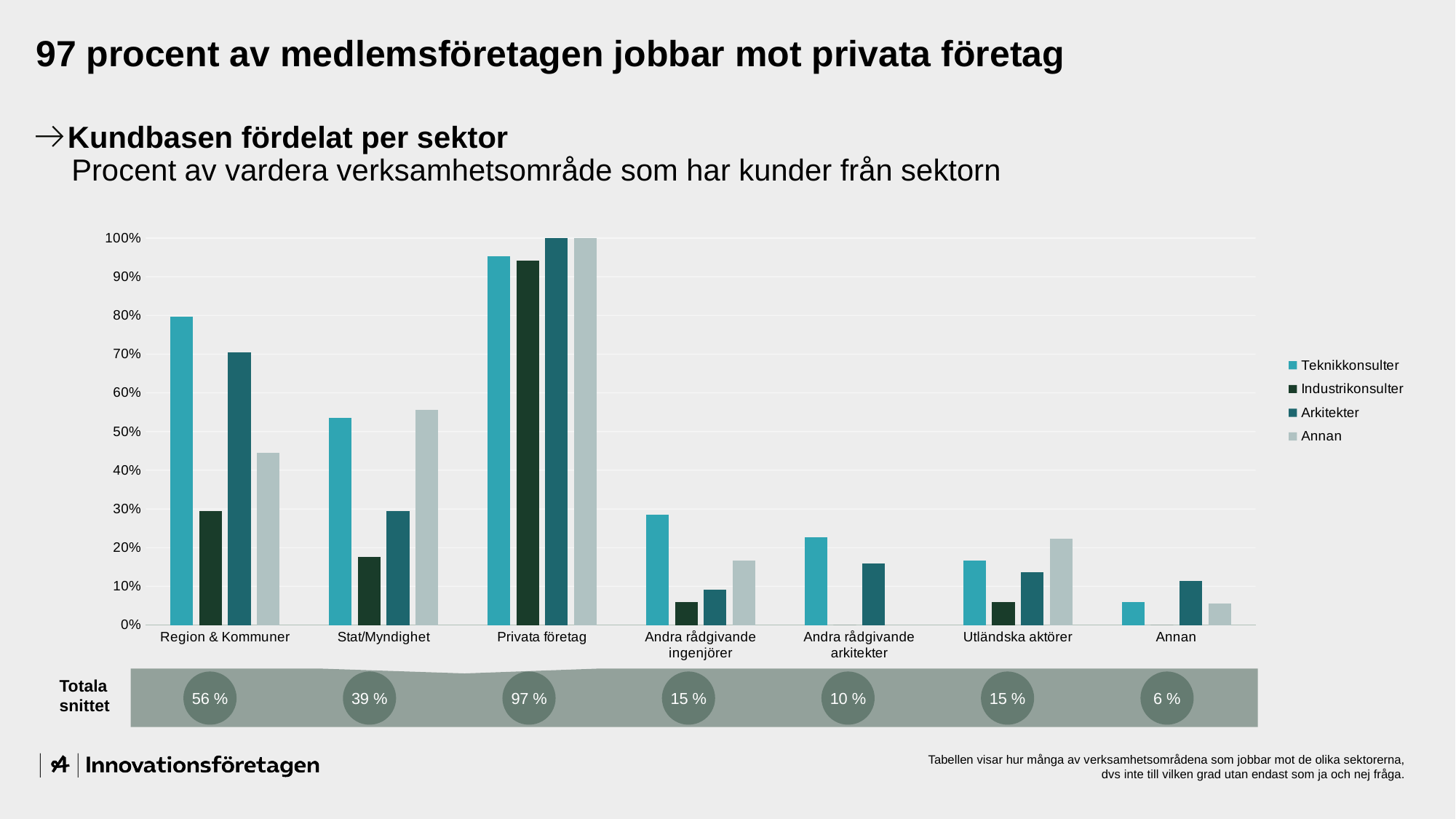
Is the value for Teknikkonsulter in the Stat/Myndighet category greater or less than 50%? greater What is the 'Totala snittet' value for Stat/Myndighet? 39 % What is the 'Totala snittet' value for Privata företag? 97 % How many series does the legend list? 4 For the Teknikkonsulter series, which sector has the highest bar? Privata företag Is the value for Industrikonsulter in the Stat/Myndighet category greater or less than 20%? less In the Region & Kommuner category, which is larger: Teknikkonsulter or Industrikonsulter? Teknikkonsulter What kind of chart is shown on the slide? bar chart How many sector categories are shown on the x axis? 7 What is the difference between the 'Totala snittet' values for Region & Kommuner and Stat/Myndighet? 17 % Which sector has the lowest 'Totala snittet' value? Annan What is the value for Arkitekter in the Privata företag category? 100%